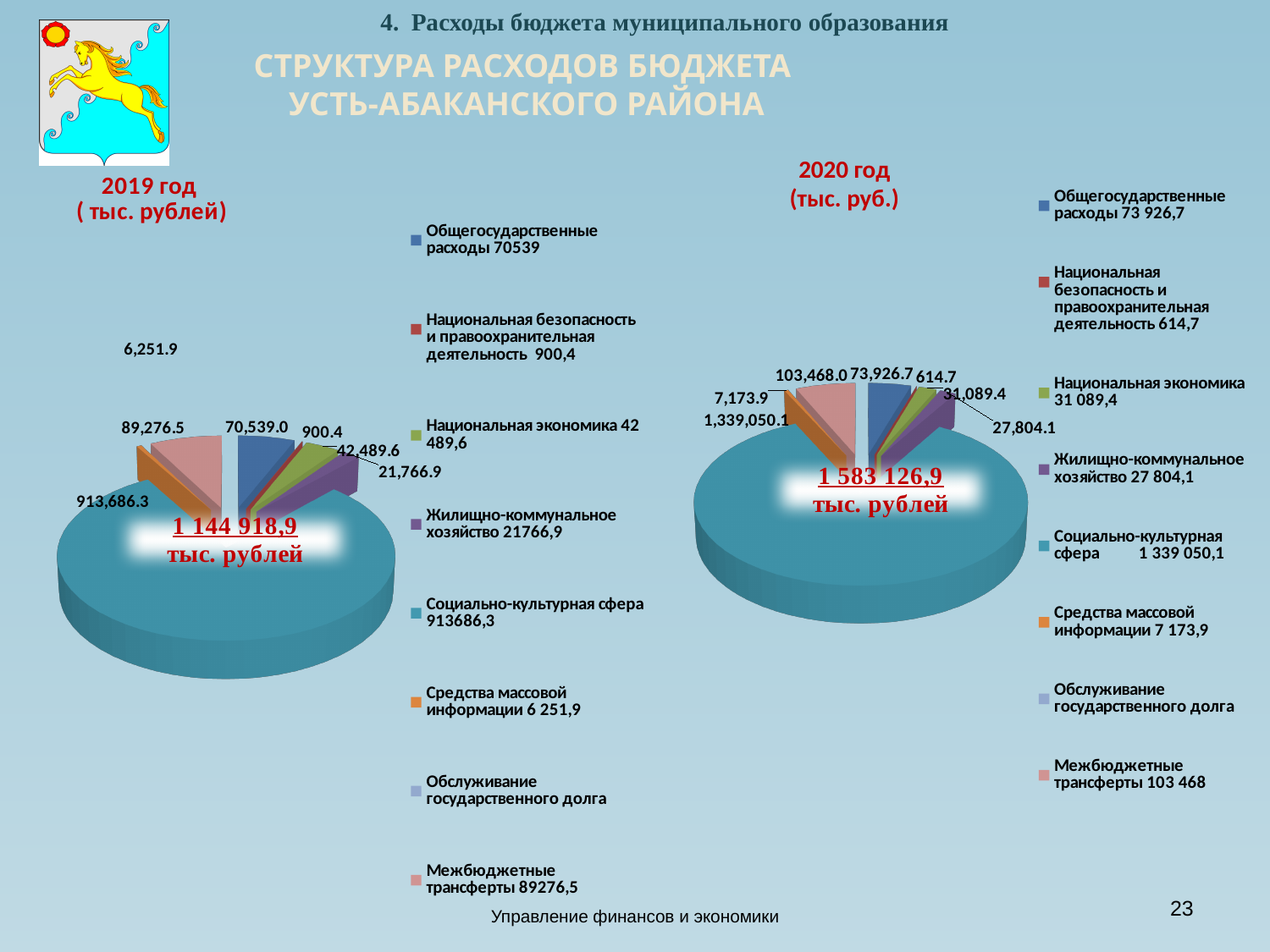
What type of chart is used for the 2019 год budget expenditure structure? pie chart How many categories does the legend of the 2020 год chart list? 8 What total is printed in the centre of the 2019 год pie chart? 1 144 918,9 тыс. рублей In the 2019 год chart, what is the difference between Межбюджетные трансферты and Общегосударственные расходы? 18,737.5 In the 2020 год chart, which category has the largest value? Социально-культурная сфера (1,339,050.1) In the 2020 год chart, what is the value for Средства массовой информации? 7,173.9 In the 2019 год chart, what is the value for Межбюджетные трансферты? 89,276.5 In the 2020 год chart, what is the value for Национальная экономика? 31,089.4 In the 2020 год chart, which is larger: Жилищно-коммунальное хозяйство or Национальная экономика? Национальная экономика In the 2019 год chart, what is the value for Социально-культурная сфера? 913,686.3 In the 2020 год chart, what is the difference between Межбюджетные трансферты and Общегосударственные расходы? 29,541.3